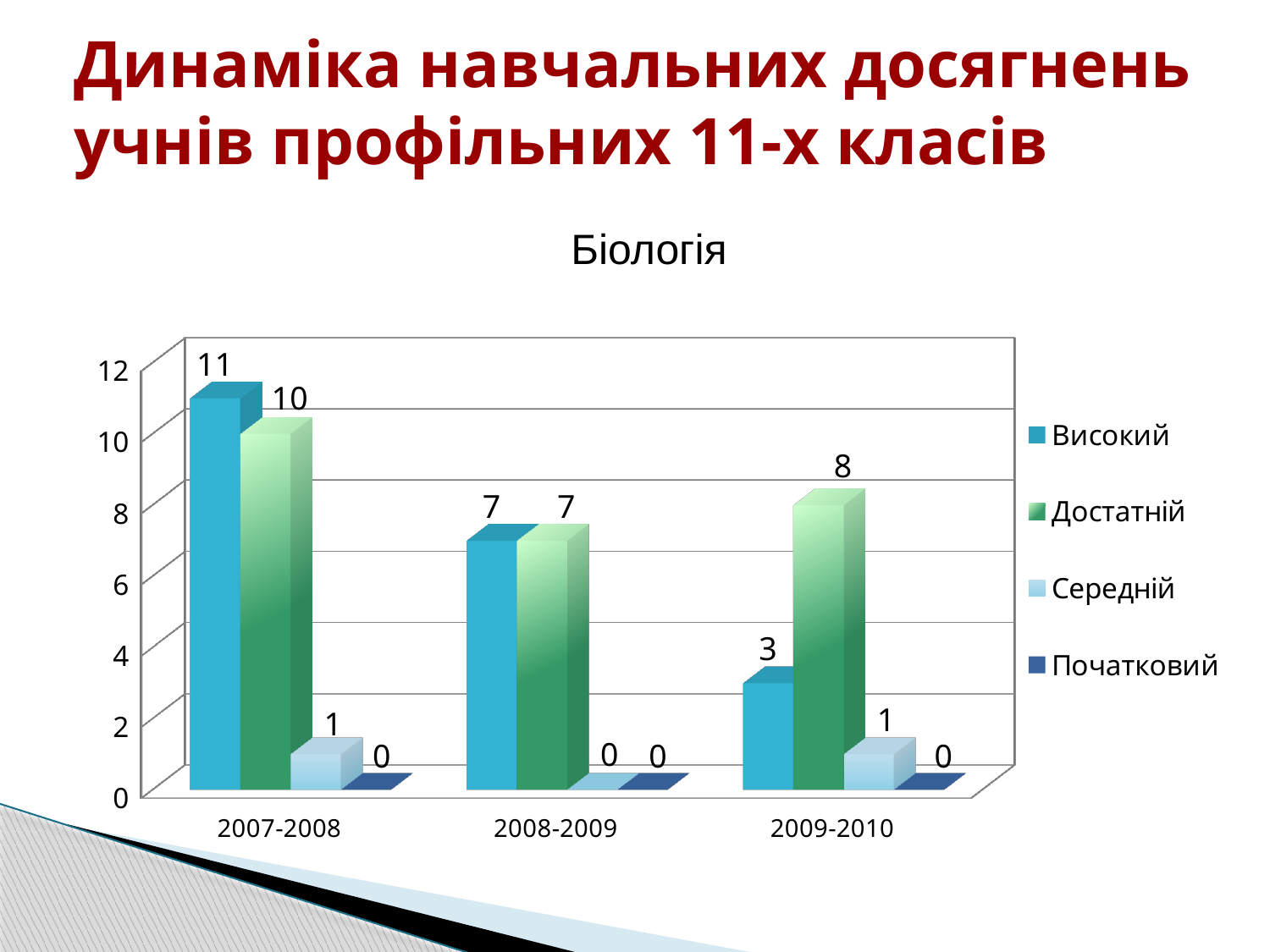
What kind of chart is shown? bar chart What is the value for Середній in 2008-2009? 0 What is the value for Високий in 2007-2008? 11 What is the difference between Високий and Достатній in 2009-2010? 5 What is the value for Достатній in 2009-2010? 8 In which year is the value for Високий the highest? 2007-2008 What is the title of the chart? Біологія How many series does the legend list? 4 In which year is the value for Високий the lowest? 2009-2010 Which is larger in 2007-2008, Високий or Достатній? Високий How many year categories are shown on the x axis? 3 Does the value for Високий rise or fall from 2007-2008 to 2009-2010? fall